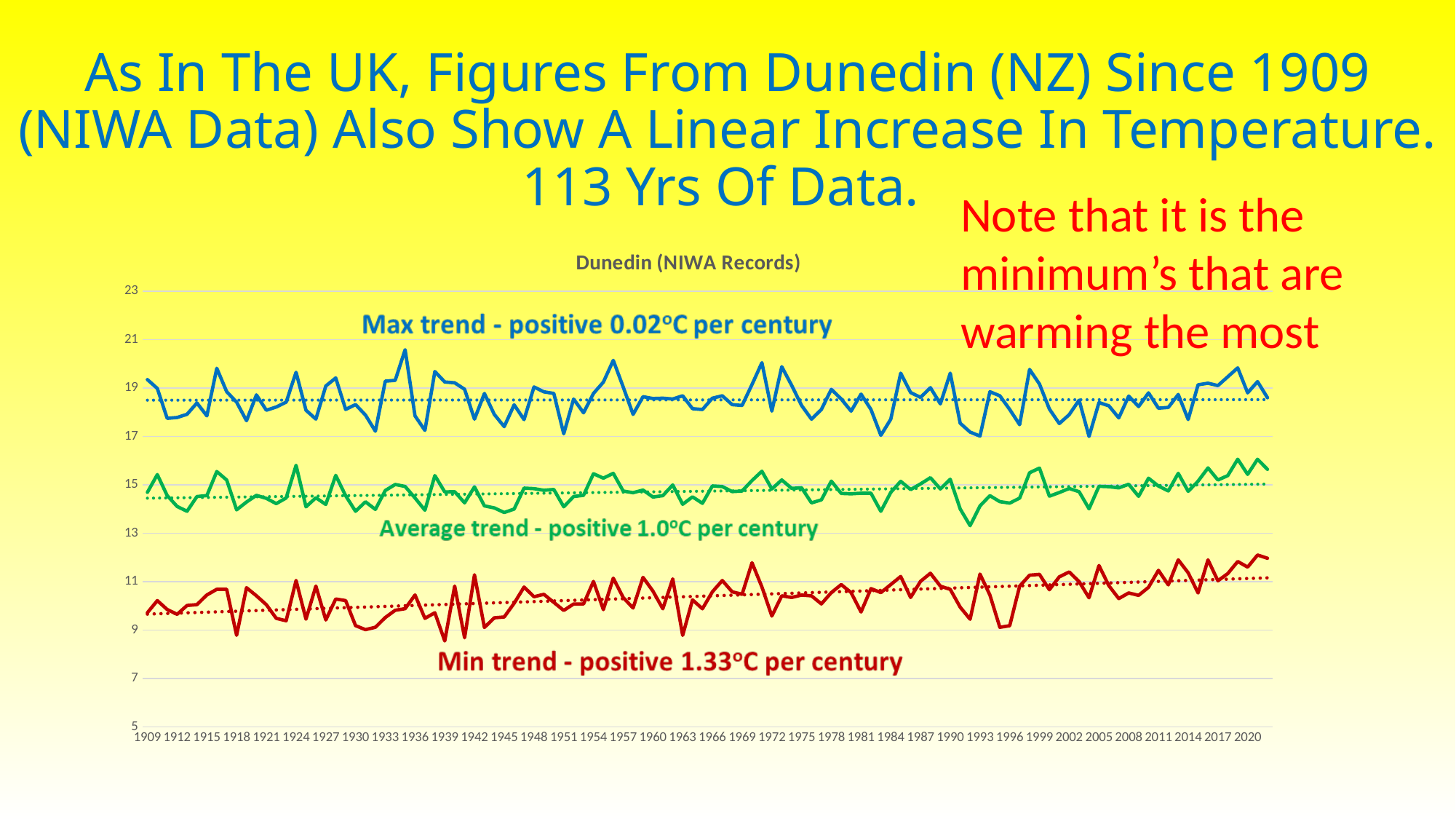
What kind of chart is shown on the slide? line chart What is the Min trend per century stated on the chart? positive 1.33°C per century What is the Max trend per century stated on the chart? positive 0.02°C per century What is the title of the chart? Dunedin (NIWA Records) How many temperature series are plotted on the chart? 3 Does the Min (red) series rise or fall overall from 1909 to 2020? rise What is the Average trend per century stated on the chart? positive 1.0°C per century Which series has the smallest stated warming trend per century? Max What is the first year shown on the x axis? 1909 Which series has the largest stated warming trend per century? Min Is the Min value for 1918 greater or less than 10? less Is the Average value for 2020 greater or less than 15? greater